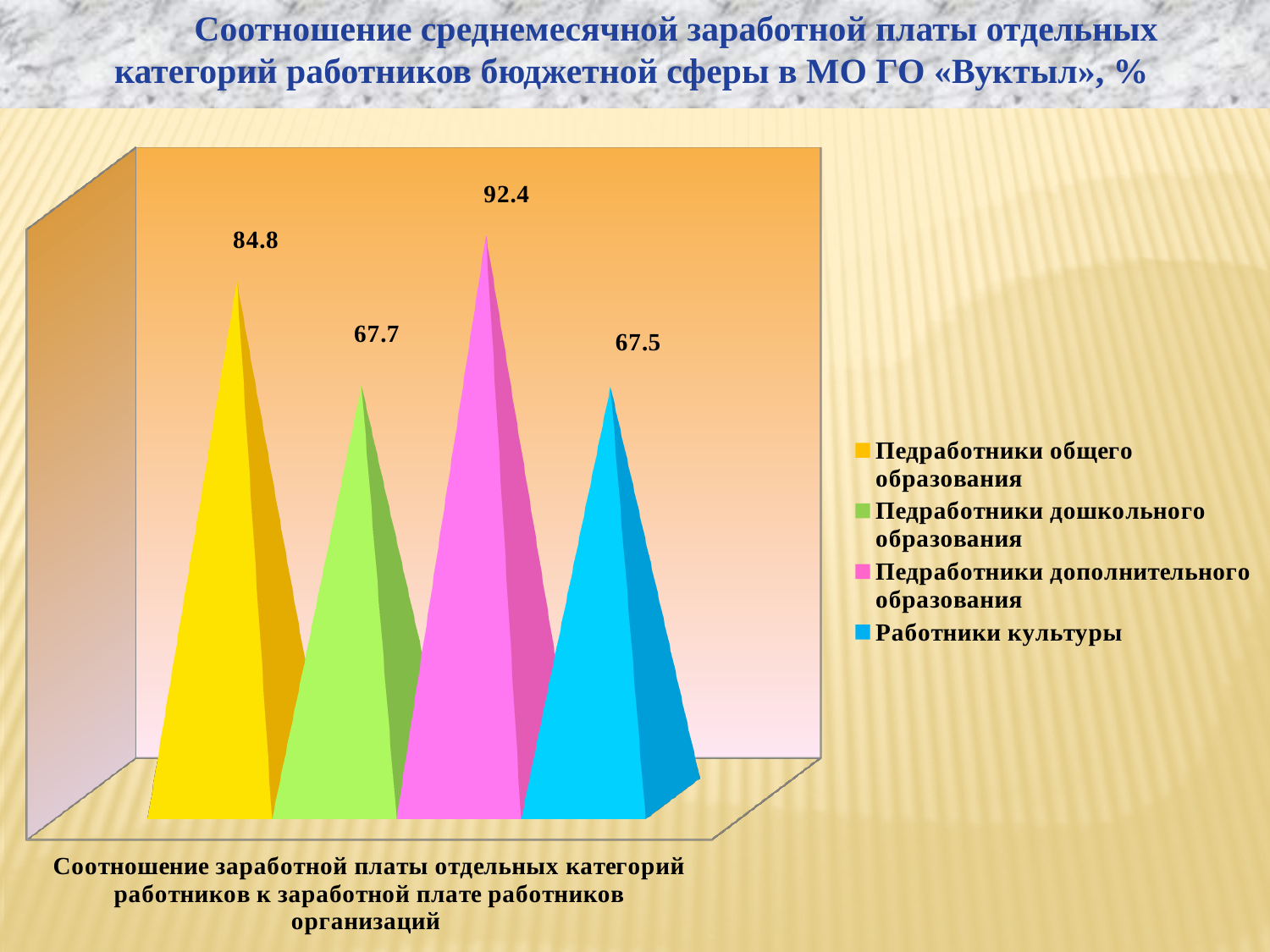
What is the value for Педработники общего образования? 84.8 How many series does the legend list? 4 What is the value for Работники культуры? 67.5 What kind of chart is shown on the slide? Bar chart What is the difference between the values for Педработники дополнительного образования and Педработники общего образования? 7.6 Which is larger: the value for Педработники общего образования or the value for Педработники дошкольного образования? Педработники общего образования What is the value for Педработники дополнительного образования? 92.4 Which series has the highest value? Педработники дополнительного образования What colour represents Работники культуры in the chart? Blue What is the difference between the values for Педработники общего образования and Работники культуры? 17.3 Which series has the lowest value? Работники культуры What is the value for Педработники дошкольного образования? 67.7